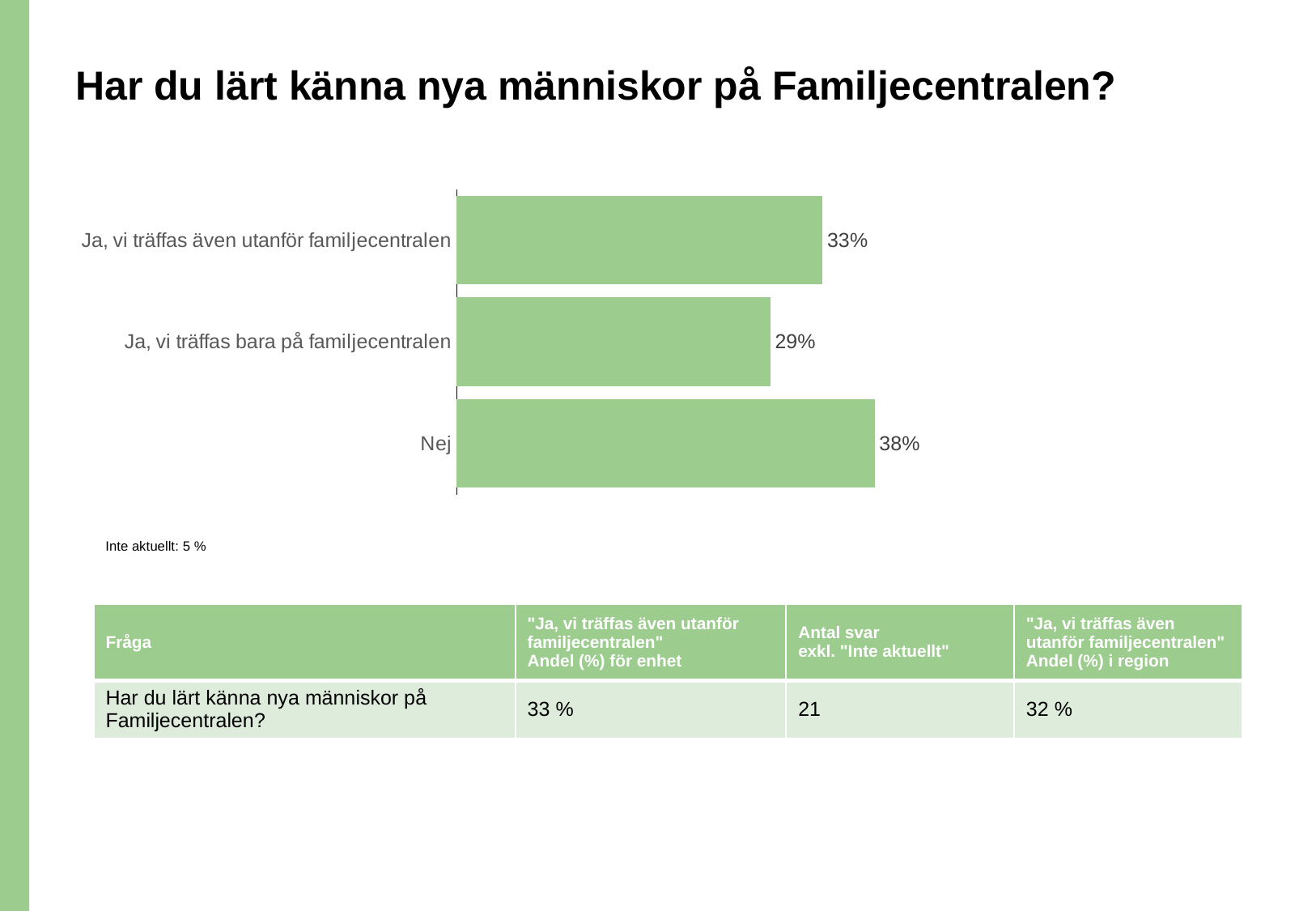
Which category has the lowest value? Ja, vi träffas bara på familjecentralen How many categories are shown in the chart? 3 Which is larger, the value for "Nej" or the value for "Ja, vi träffas även utanför familjecentralen"? Nej What is the value for "Nej"? 38% What is the value for "Ja, vi träffas bara på familjecentralen"? 29% What colour are the bars in the chart? Green What is the difference between the values for "Nej" and "Ja, vi träffas bara på familjecentralen"? 9% What kind of chart is shown on the slide? Bar chart Which category has the highest value? Nej What is the value for "Ja, vi träffas även utanför familjecentralen"? 33% What is the difference between the values for "Ja, vi träffas även utanför familjecentralen" and "Ja, vi träffas bara på familjecentralen"? 4% What is the title of the slide containing the chart? Har du lärt känna nya människor på Familjecentralen?